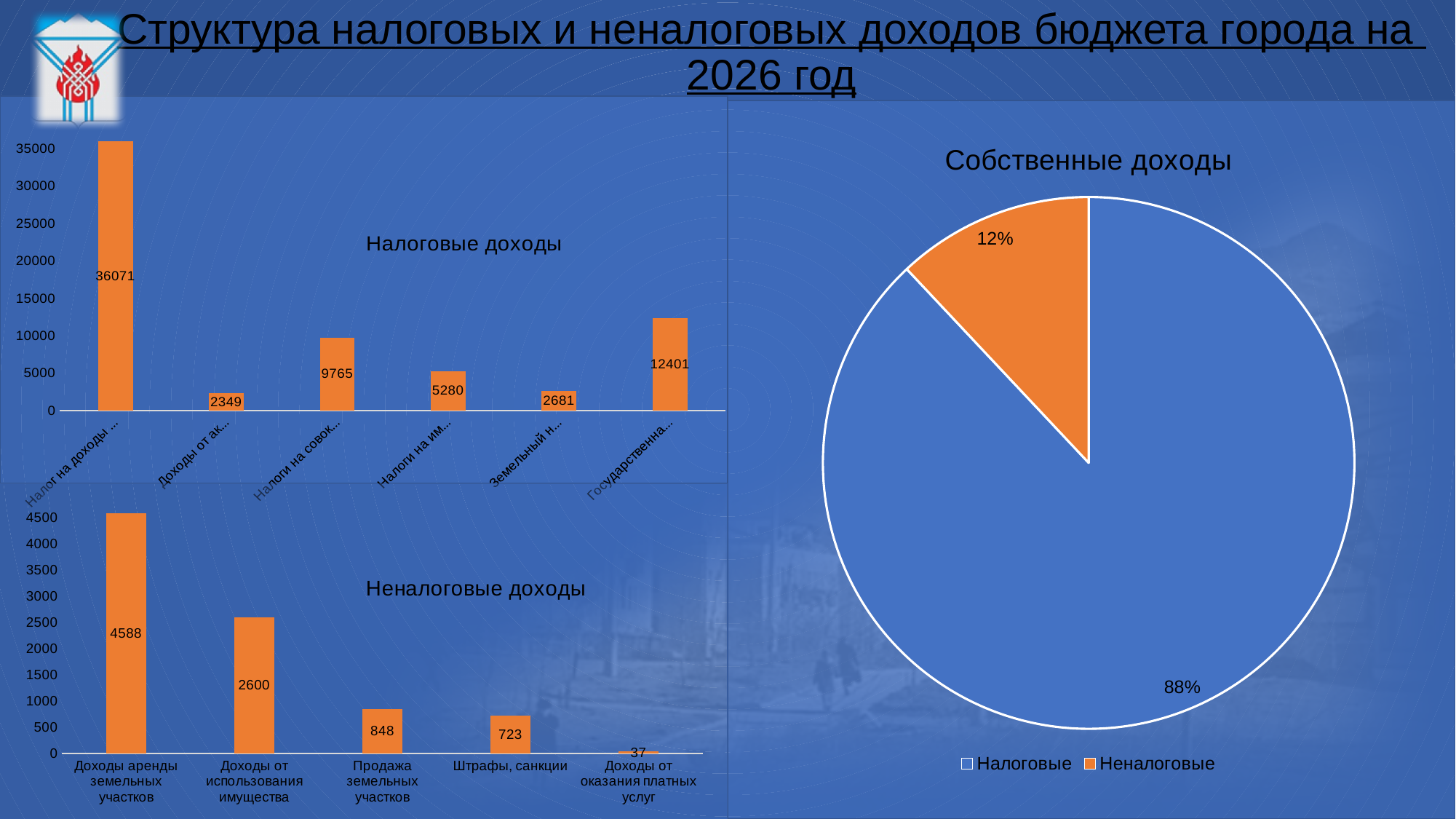
On the 'Неналоговые доходы' chart, how many categories are shown? 5 On the 'Налоговые доходы' chart, what is the value of the last (rightmost) bar, labelled 'Государственна...'? 12401 On the 'Налоговые доходы' chart, which is larger: the bar labelled 'Налоги на совок...' or the bar labelled 'Налоги на им...'? Налоги на совок... On the 'Неналоговые доходы' chart, what is the value for 'Штрафы, санкции'? 723 On the 'Неналоговые доходы' chart, what is the value for 'Доходы аренды земельных участков'? 4588 On the 'Неналоговые доходы' chart, what is the difference between 'Доходы от использования имущества' and 'Продажа земельных участков'? 1752 On the 'Налоговые доходы' chart, what is the value of the first (leftmost) bar, labelled 'Налог на доходы ...'? 36071 On the 'Неналоговые доходы' chart, which category has the lowest value? Доходы от оказания платных услуг On the 'Налоговые доходы' chart, how many bars are shown? 6 On the 'Собственные доходы' pie chart, what share is 'Неналоговые'? 12% What type of chart is 'Собственные доходы'? pie chart On the 'Собственные доходы' pie chart, how many entries does the legend list? 2